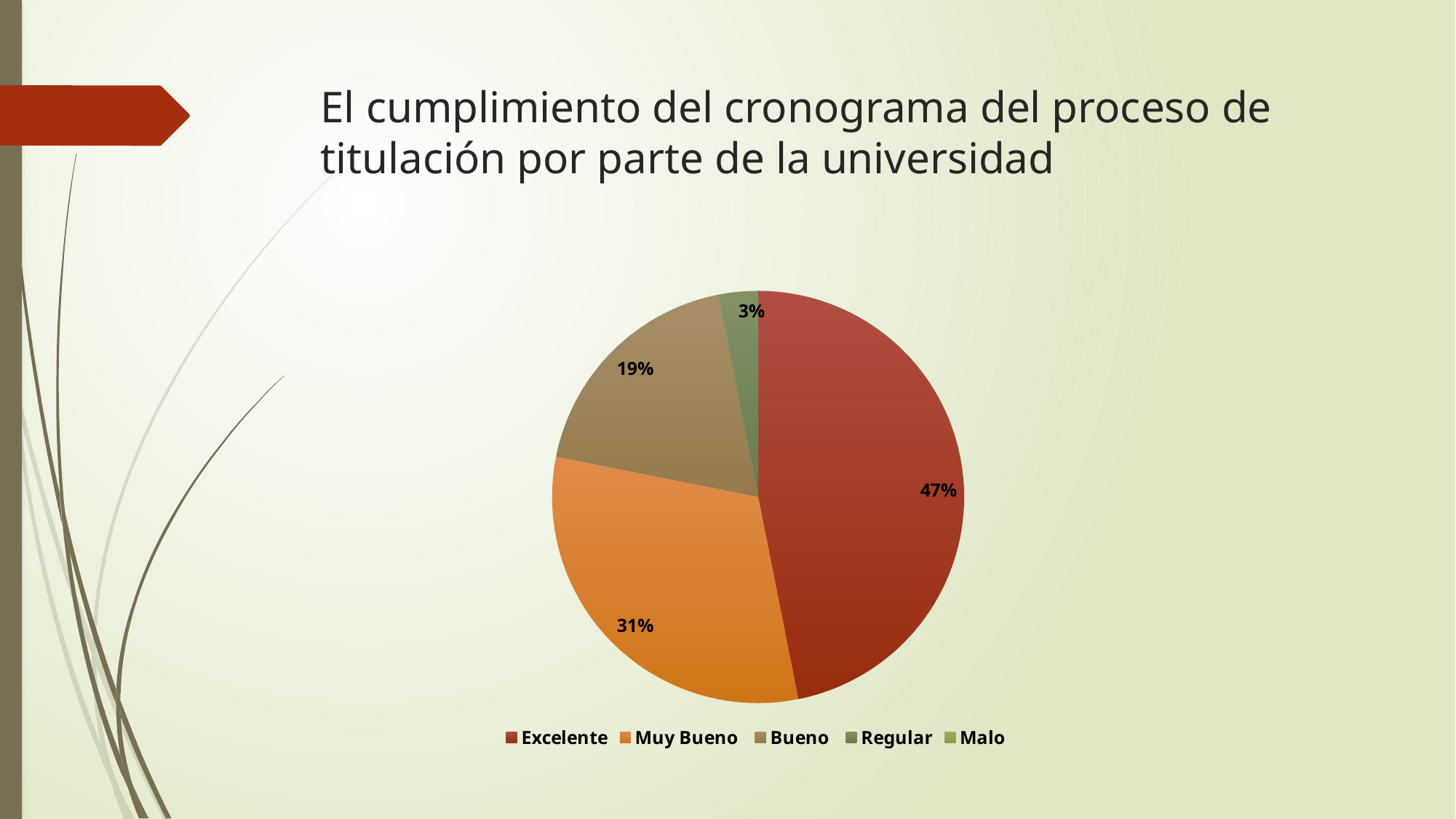
How many slices with data labels are shown in the pie? 4 Which slice is larger, Bueno or Muy Bueno? Muy Bueno What percentage of the pie is labelled Bueno? 19% Which category has the largest slice of the pie? Excelente How many percentage points larger is the Excelente slice than the Muy Bueno slice? 16 percentage points What percentage of the pie is labelled Excelente? 47% What colour is the Excelente slice? Red Which of the labelled slices is the smallest? Regular What percentage of the pie is labelled Regular? 3% What kind of chart is shown on the slide? Pie chart What percentage of the pie is labelled Muy Bueno? 31% How many categories does the legend list? 5